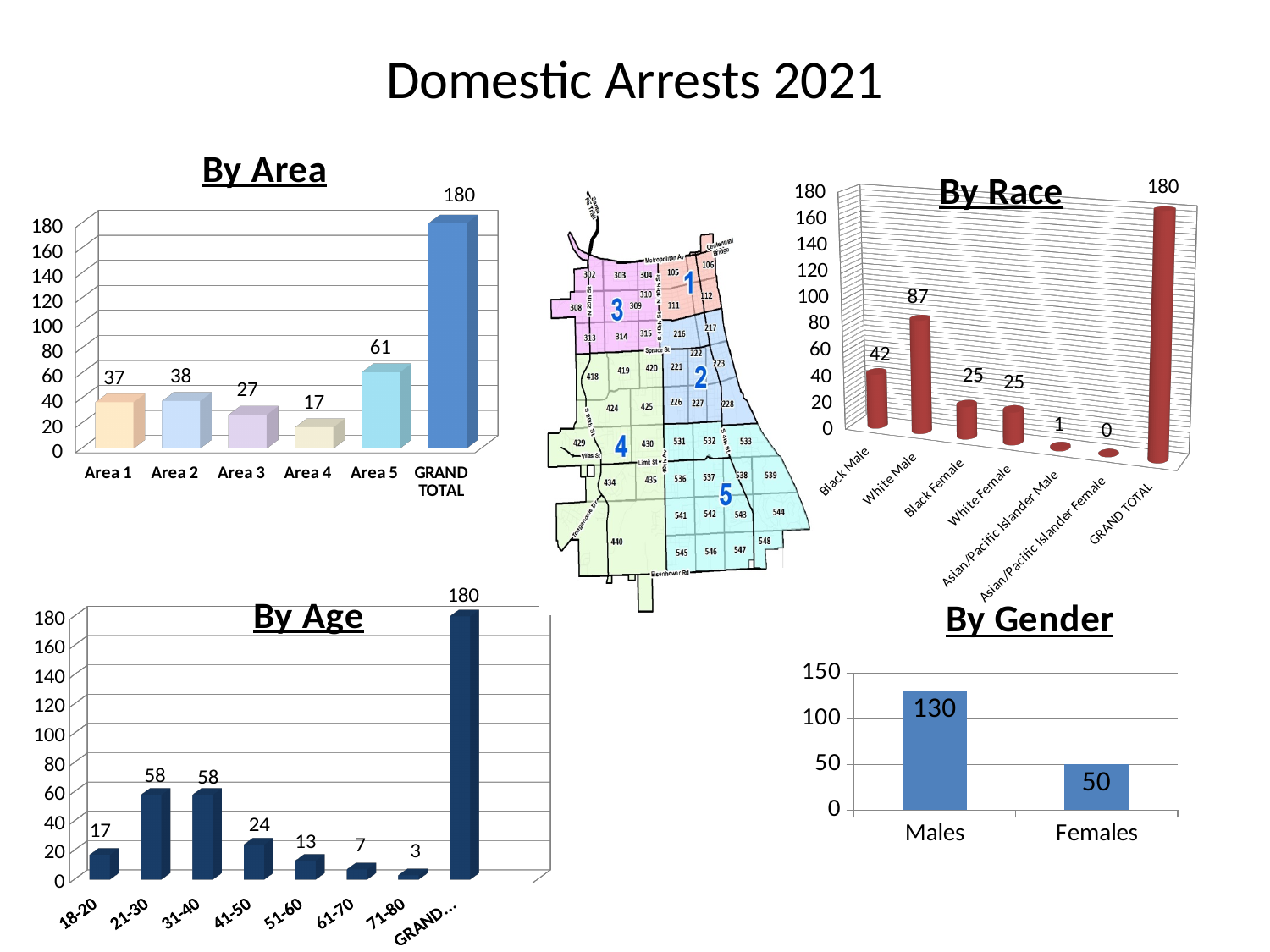
In the By Race chart, what is the value for White Male? 87 In the By Area chart, what is the value for Area 5? 61 In the By Area chart, what is the difference between Area 2 and Area 3? 11 In the By Gender chart, what is the difference between Males and Females? 80 In the By Race chart, which category (excluding the grand total) has the highest value? White Male In the By Age chart, what is the value for the 41-50 age group? 24 In the By Area chart, which area (excluding the grand total) has the lowest value? Area 4 In the By Gender chart, is the value for Males greater or less than 100? greater In the By Race chart, what is the value for Asian/Pacific Islander Female? 0 In the By Age chart, which is larger, the value for 18-20 or the value for 51-60? 18-20 In the By Age chart, how many age groups are shown, excluding the grand total? 7 What kind of chart is the By Gender chart? Bar chart